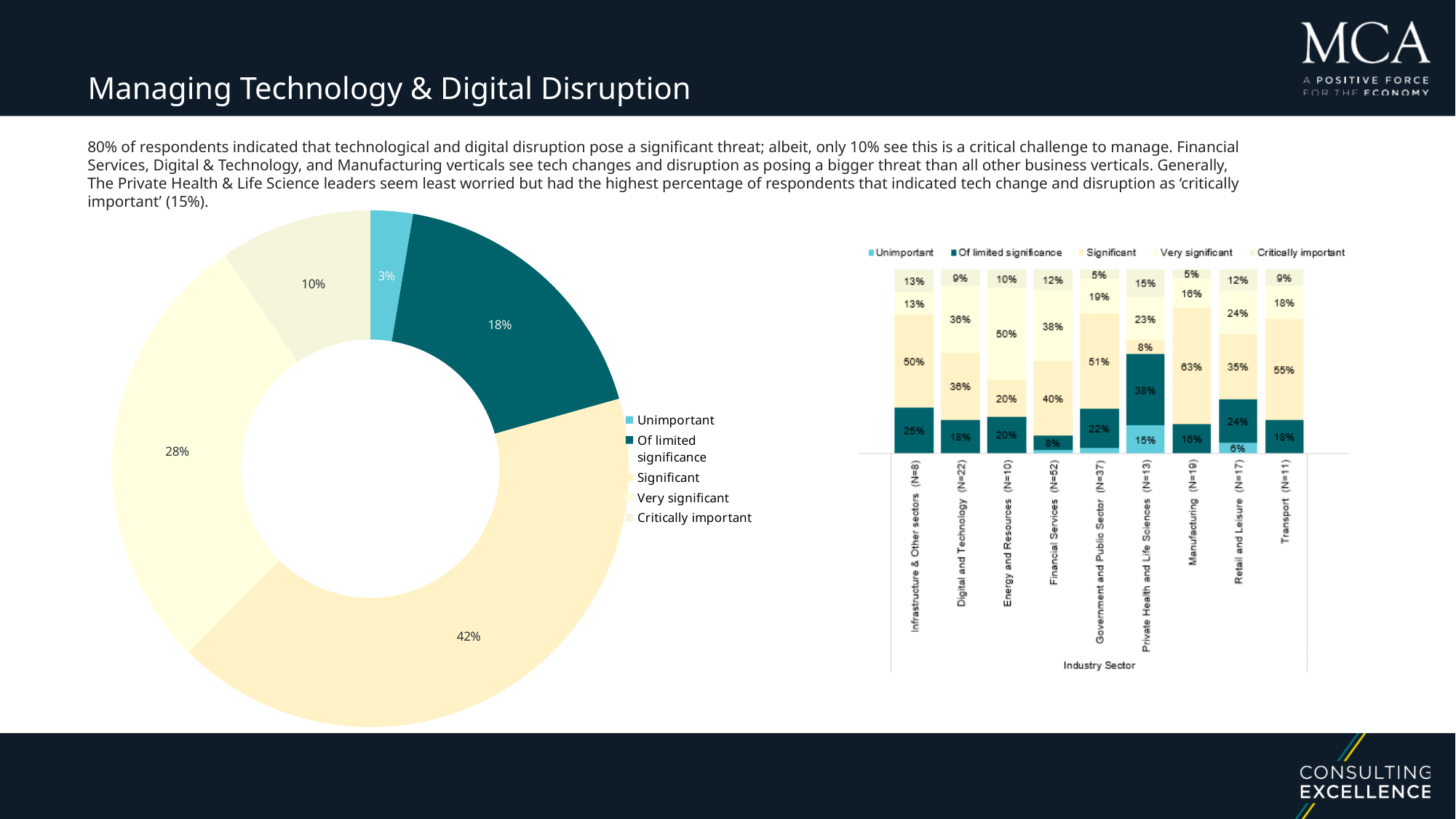
In the donut chart on the left, what percentage of respondents rated technology and digital disruption as 'Significant'? 42% In the stacked bar chart on the right, which sector has the largest 'Significant' segment? Manufacturing In the stacked bar chart on the right, what percentage of Private Health and Life Sciences respondents rated it 'Critically important'? 15% In the donut chart on the left, which category has the smallest share? Unimportant In the stacked bar chart on the right, is the 'Significant' share for Transport larger or smaller than for Retail and Leisure? Larger What type of chart is shown on the right of the slide? Stacked bar chart In the stacked bar chart on the right, how many industry sectors are shown on the x axis? 9 In the donut chart on the left, what is the difference between the 'Very significant' and 'Critically important' shares? 18% In the donut chart on the left, what percentage of respondents rated it 'Unimportant'? 3% In the stacked bar chart on the right, what percentage of Manufacturing respondents rated it 'Significant'? 63% In the donut chart on the left, which category has the largest share? Significant How many categories does the legend of the donut chart on the left list? 5